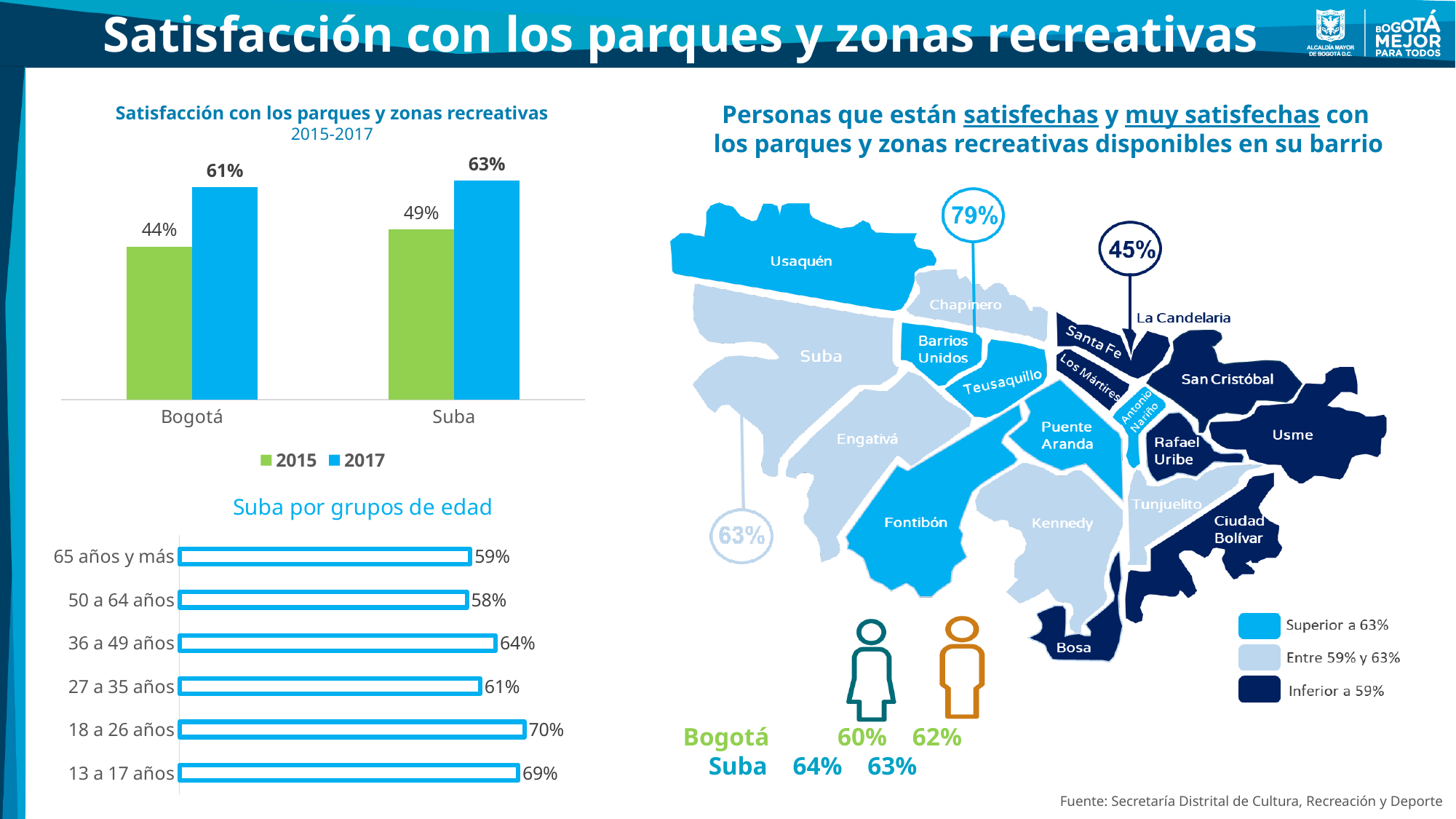
In the chart 'Satisfacción con los parques y zonas recreativas 2015-2017', what is the value for Bogotá in 2015? 44% In the chart 'Satisfacción con los parques y zonas recreativas 2015-2017', which is larger: Suba in 2015 or Bogotá in 2015? Suba in 2015 In the chart 'Satisfacción con los parques y zonas recreativas 2015-2017', by how many percentage points did Bogotá's value increase from 2015 to 2017? 17 percentage points In the chart 'Suba por grupos de edad', which age group has the lowest value? 50 a 64 años In the chart 'Suba por grupos de edad', what is the value for the 18 a 26 años group? 70% In the chart 'Satisfacción con los parques y zonas recreativas 2015-2017', which colour represents the 2015 series? Green In the chart 'Suba por grupos de edad', which age group has the highest value? 18 a 26 años In the chart 'Suba por grupos de edad', what is the difference between the 36 a 49 años group and the 65 años y más group? 5 percentage points How many series does the legend of the chart 'Satisfacción con los parques y zonas recreativas 2015-2017' list? 2 What kind of chart is 'Satisfacción con los parques y zonas recreativas 2015-2017'? Bar chart How many age groups are shown in the chart 'Suba por grupos de edad'? 6 In the chart 'Satisfacción con los parques y zonas recreativas 2015-2017', what is the value for Suba in 2017? 63%